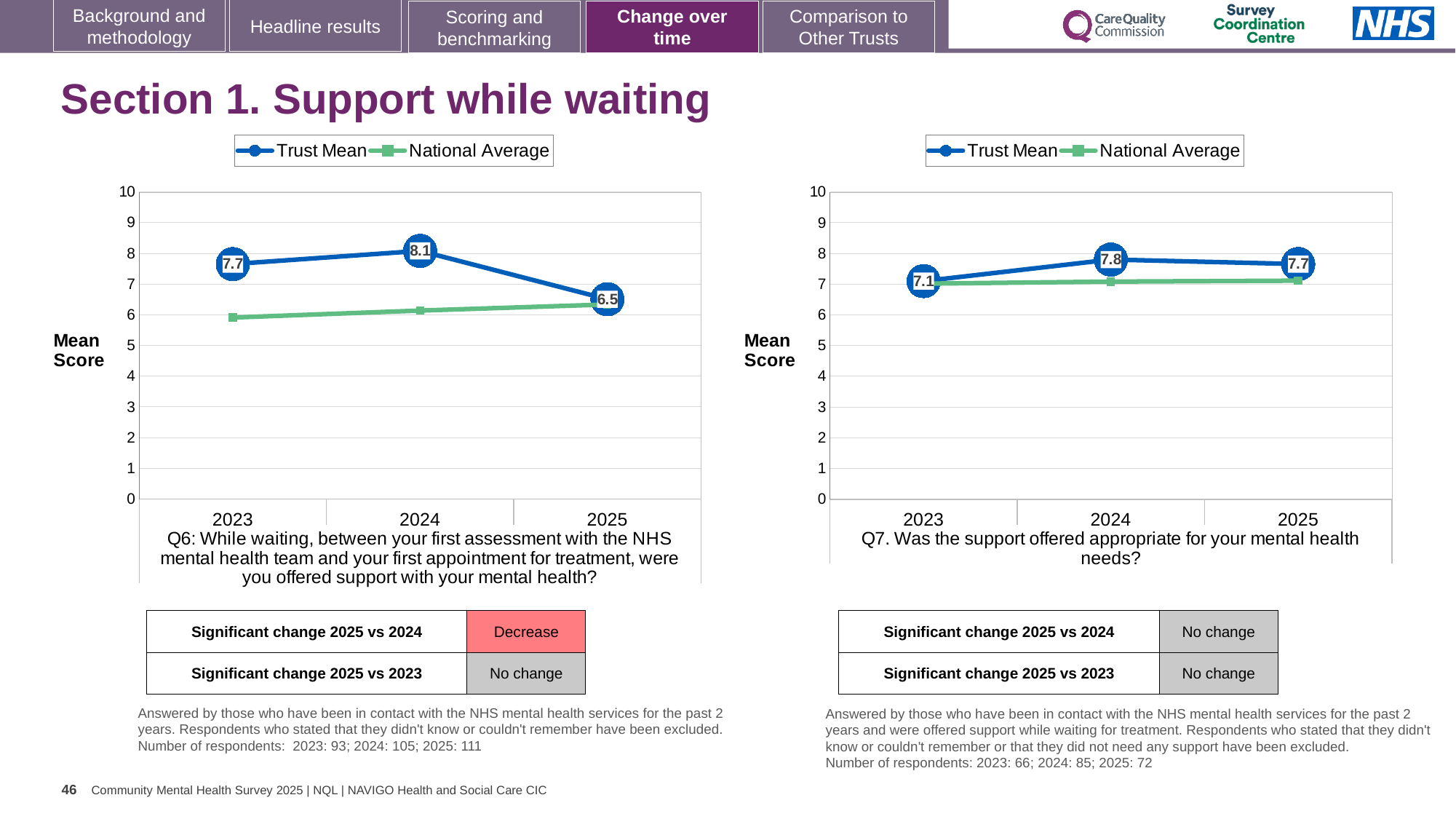
In the left chart (Q6), is the National Average for 2025 greater or less than 6? greater In the right chart (Q7), is the Trust Mean higher in 2023 or in 2024? 2024 How many years are shown on the x axis of the left chart (Q6)? 3 In the right chart (Q7), is the National Average for 2025 greater or less than 8? less In the right chart (Q7), what is the difference between the Trust Mean in 2024 and in 2023? 0.7 In the left chart (Q6), what is the difference between the Trust Mean in 2024 and in 2025? 1.6 How many series does the legend of the right chart (Q7) list? 2 In the left chart (Q6), what is the Trust Mean for 2024? 8.1 In the right chart (Q7), which year has the highest Trust Mean? 2024 What type of chart is the left chart (Q6)? Line chart In the right chart (Q7), what is the Trust Mean for 2023? 7.1 In the left chart (Q6), which year has the lowest Trust Mean? 2025